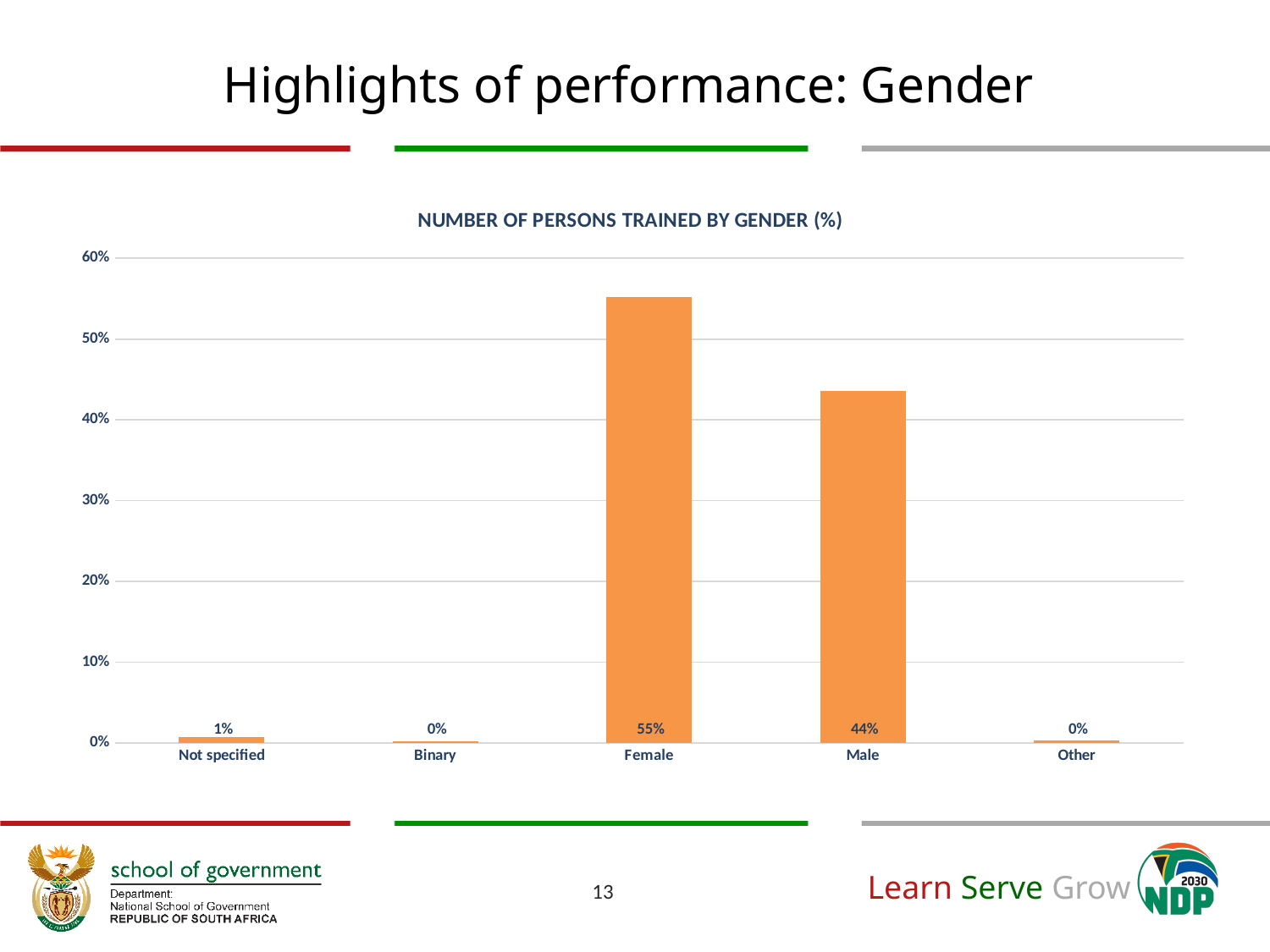
Is the value for Male greater or less than 50%? less What is the difference between the Female and Male values? 11% What is the value for Not specified? 1% What is the title of the chart? NUMBER OF PERSONS TRAINED BY GENDER (%) How many categories are shown on the x axis? 5 What is the value for Female? 55% Is the value for Female greater or less than 50%? greater Which category has the highest value? Female What is the value for Male? 44% What kind of chart is shown? bar chart Which is larger, the value for Female or the value for Male? Female What is the value for Binary? 0%